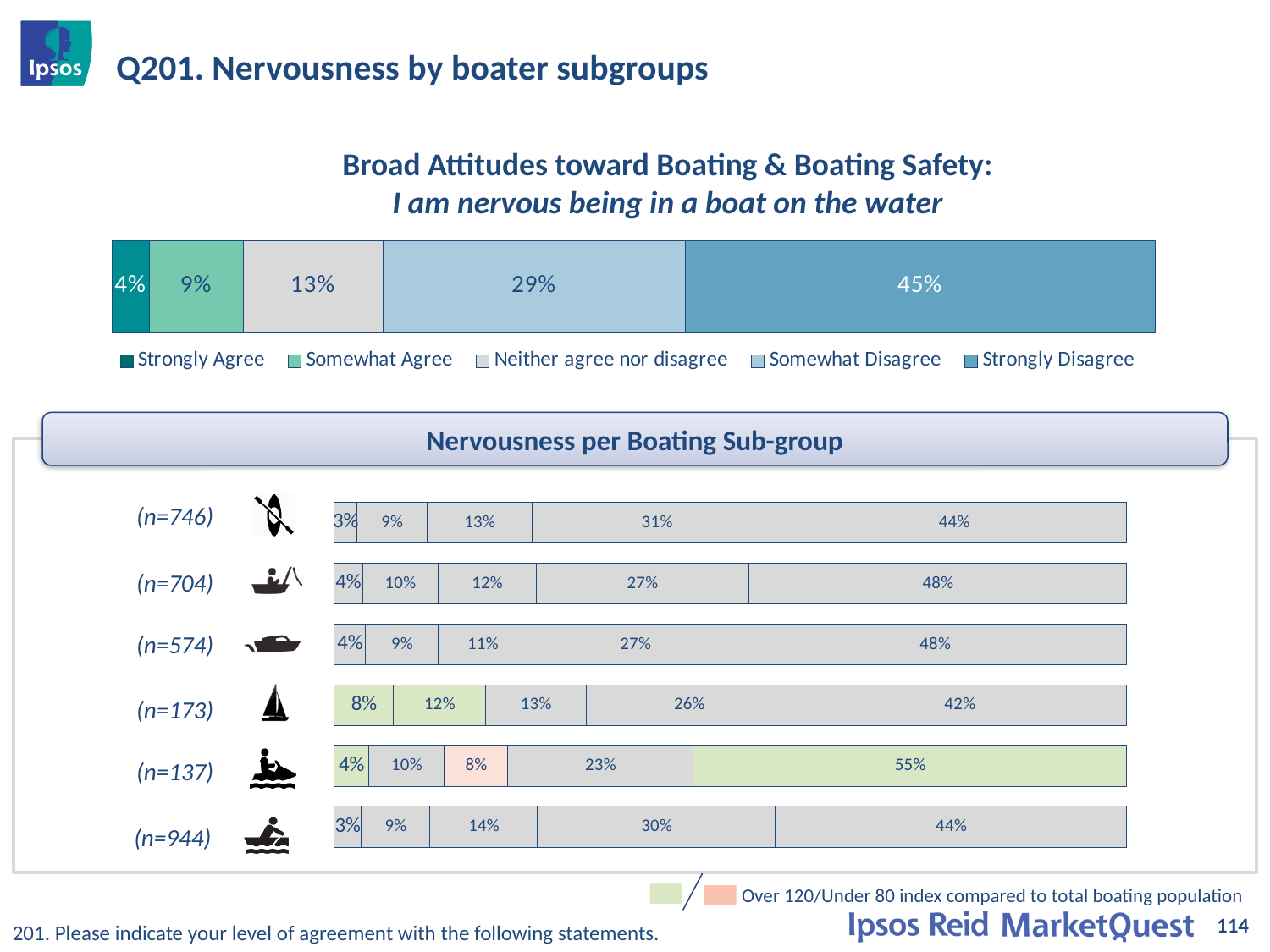
In the top chart (I am nervous being in a boat on the water), which response category has the largest share? Strongly Disagree What type of chart is used in the Nervousness per Boating Sub-group section? Stacked bar chart In the Nervousness per Boating Sub-group chart, is the Somewhat Disagree value larger for the (n=746) sub-group or the (n=137) sub-group? (n=746) In the top chart (I am nervous being in a boat on the water), how many series does the legend list? 5 In the top chart (I am nervous being in a boat on the water), which response category has the smallest share? Strongly Agree In the Nervousness per Boating Sub-group chart, which sub-group has the highest Strongly Disagree value? (n=137) In the top chart (I am nervous being in a boat on the water), what is the difference between the Strongly Disagree and Somewhat Disagree shares? 16% In the Nervousness per Boating Sub-group chart, how many sub-groups (bars) are shown? 6 In the top chart (I am nervous being in a boat on the water), what percentage of respondents Strongly Disagree? 45% In the Nervousness per Boating Sub-group chart, what is the Strongly Agree value for the (n=173) sub-group? 8% In the top chart (I am nervous being in a boat on the water), what percentage of respondents Somewhat Agree? 9% In the Nervousness per Boating Sub-group chart, what is the Strongly Disagree value for the (n=137) sub-group? 55%